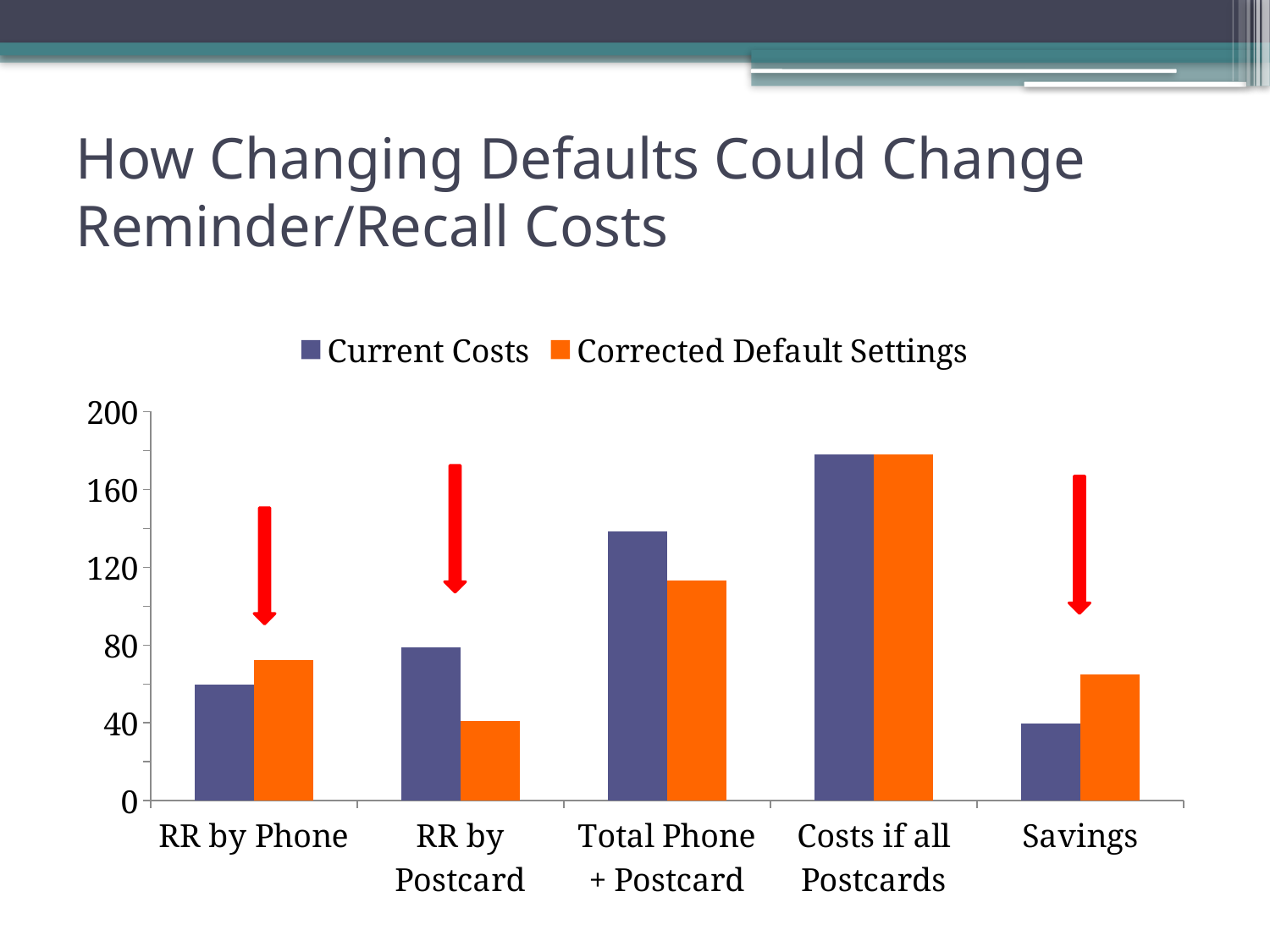
Which category has the lowest Corrected Default Settings value? RR by Postcard Is the Current Costs value for RR by Phone greater or less than 80? less How many categories are shown on the x axis of the chart? 5 Which category has the highest Current Costs value? Costs if all Postcards How many series does the chart's legend list? 2 Which category has the lowest Current Costs value? Savings Is the Corrected Default Settings value for Costs if all Postcards greater or less than 160? greater What kind of chart is shown on the slide? Bar chart For RR by Postcard, which is larger: Current Costs or Corrected Default Settings? Current Costs For Savings, which is larger: Current Costs or Corrected Default Settings? Corrected Default Settings Is the Current Costs value for Total Phone + Postcard greater or less than 120? greater Which colour represents the Corrected Default Settings series in the chart? Orange